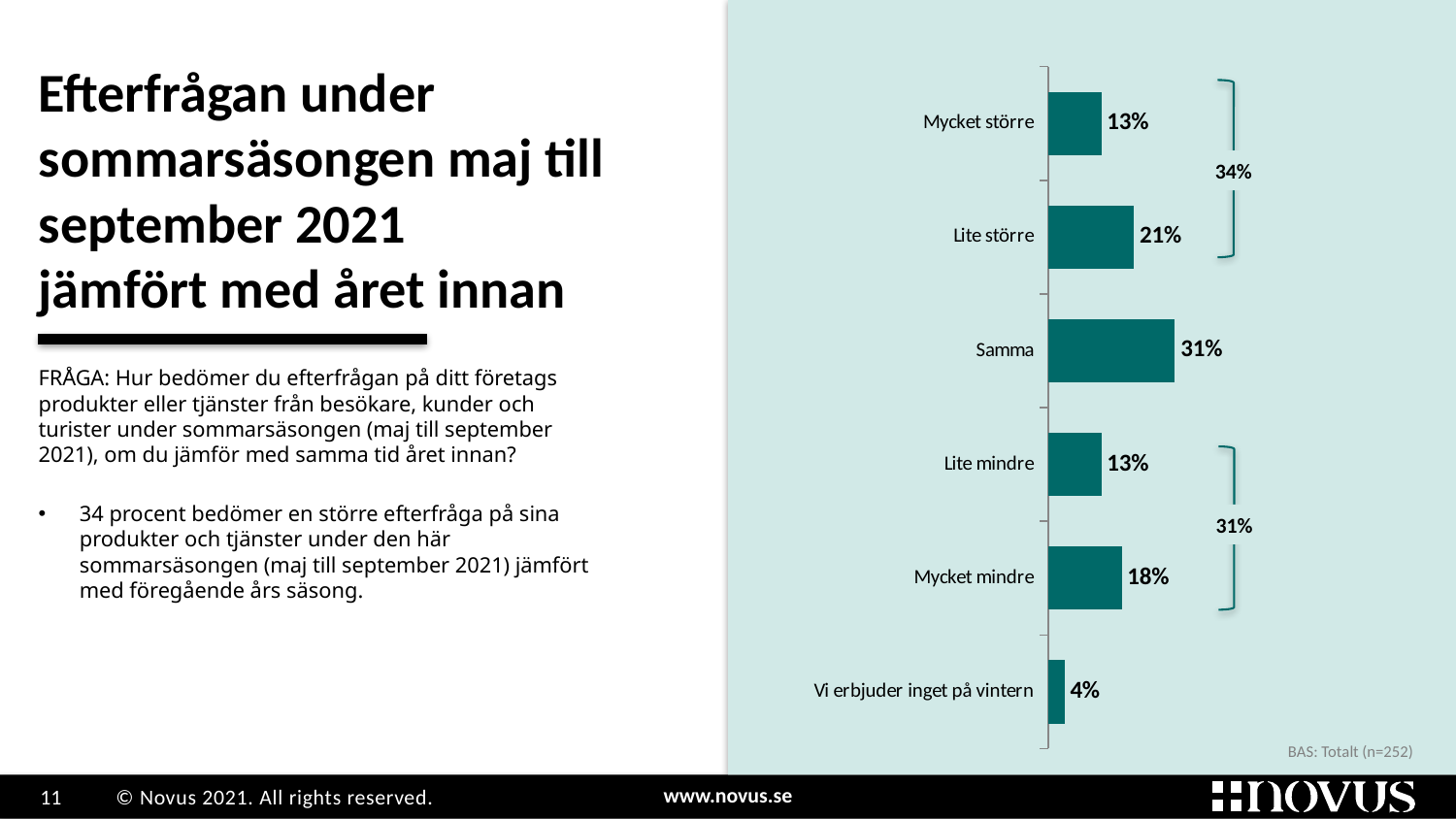
What kind of chart is shown on the slide? Bar chart Which category has the lowest value? Vi erbjuder inget på vintern Which category has the highest value? Samma What is the value for "Vi erbjuder inget på vintern"? 4% What combined percentage is shown by the bracket grouping "Mycket större" and "Lite större"? 34% Which is larger, the value for "Mycket mindre" or the value for "Lite mindre"? Mycket mindre What is the value for "Mycket mindre"? 18% What is the value for "Samma"? 31% What is the difference between the values for "Lite större" and "Mycket större"? 8% What is the base (n) stated below the chart? Totalt (n=252) How many categories are shown in the chart? 6 What is the value for "Lite större"? 21%